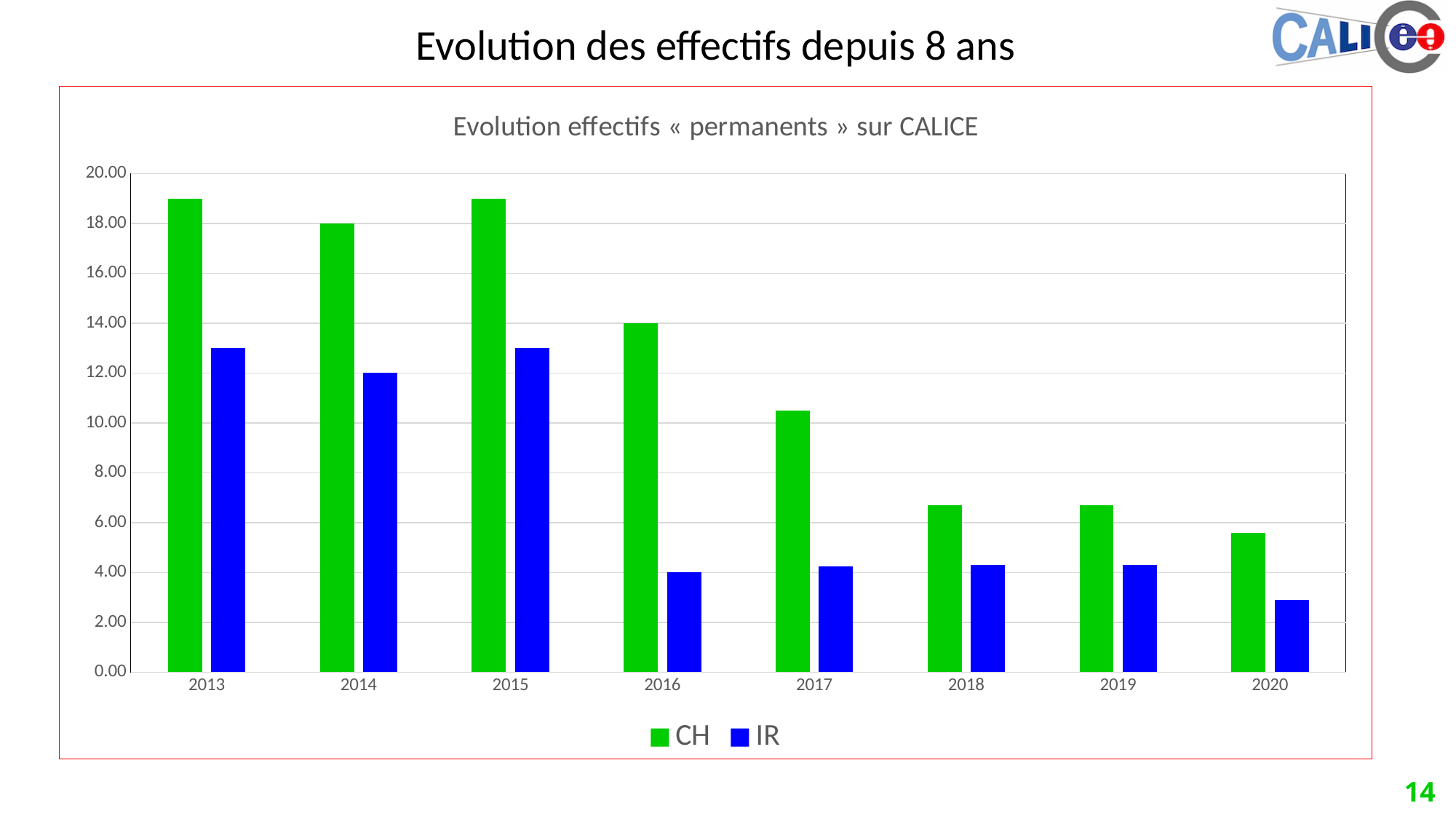
Is the CH value for 2013 greater or less than 18.00? greater Do the CH values generally rise or fall from 2013 to 2020? fall Is the CH value for 2017 greater or less than 10.00? greater What is the CH value for 2014? 18.00 Which year has the lowest CH value? 2020 How many years are shown on the x axis? 8 What is the IR value for 2016? 4.00 In 2016, which series has the larger value, CH or IR? CH What kind of chart is shown on the slide? bar chart Which year has the lowest IR value? 2020 Is the IR value for 2020 greater or less than 4.00? less How many series does the legend list? 2